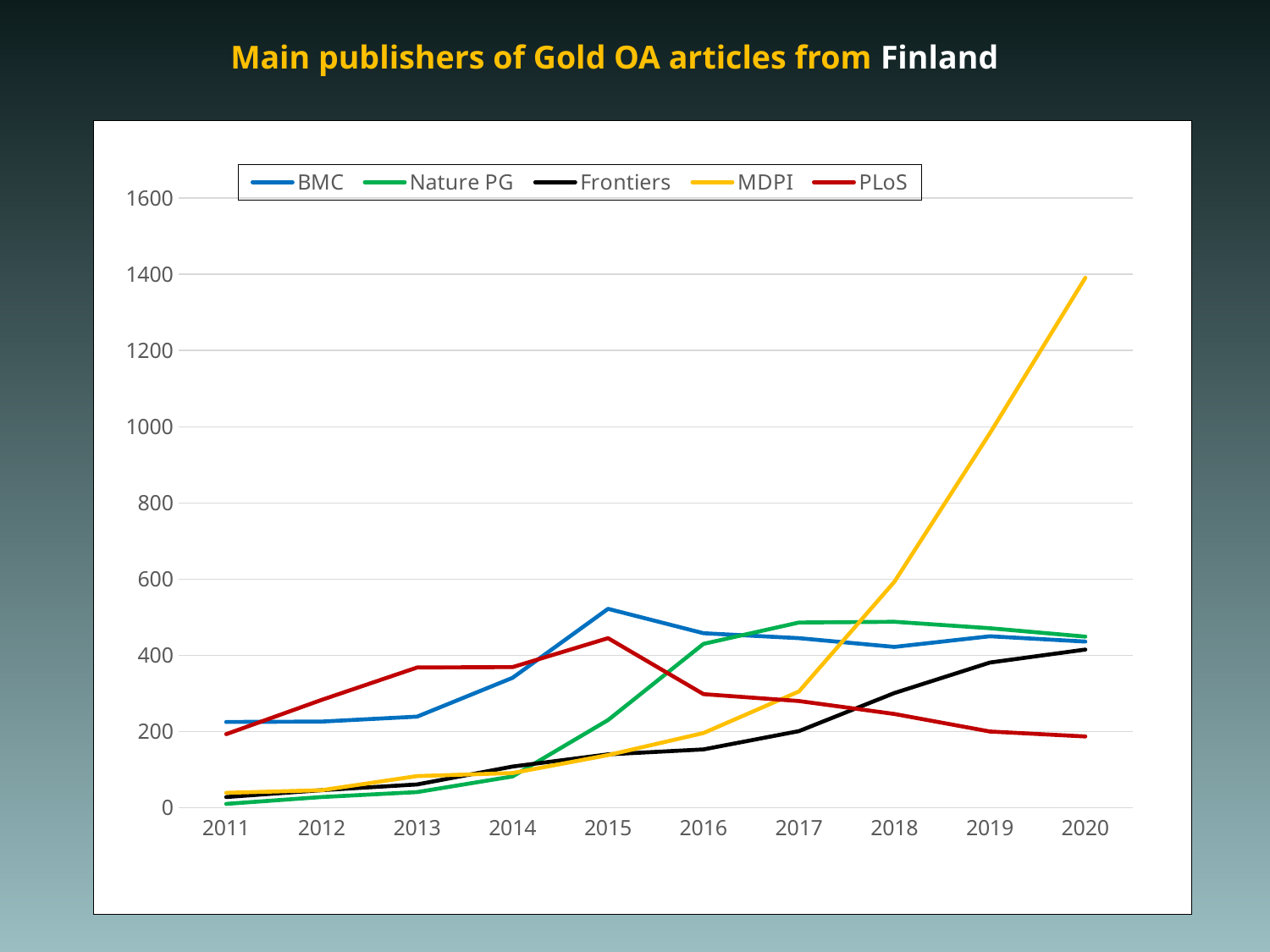
In 2013, which is larger: the value for PLoS or the value for BMC? PLoS Which publisher has the highest value in 2020? MDPI How many years are shown on the x axis? 10 Does the MDPI line rise or fall from 2011 to 2020? rise Is the value for Frontiers in 2011 greater or less than 100? less Is the value for MDPI in 2020 greater or less than 1200? greater Which publisher has the highest value in 2015? BMC What is the title of the chart? Main publishers of Gold OA articles from Finland How many series does the legend list? 5 Which publisher has the lowest value in 2020? PLoS What kind of chart is shown on the slide? Line chart